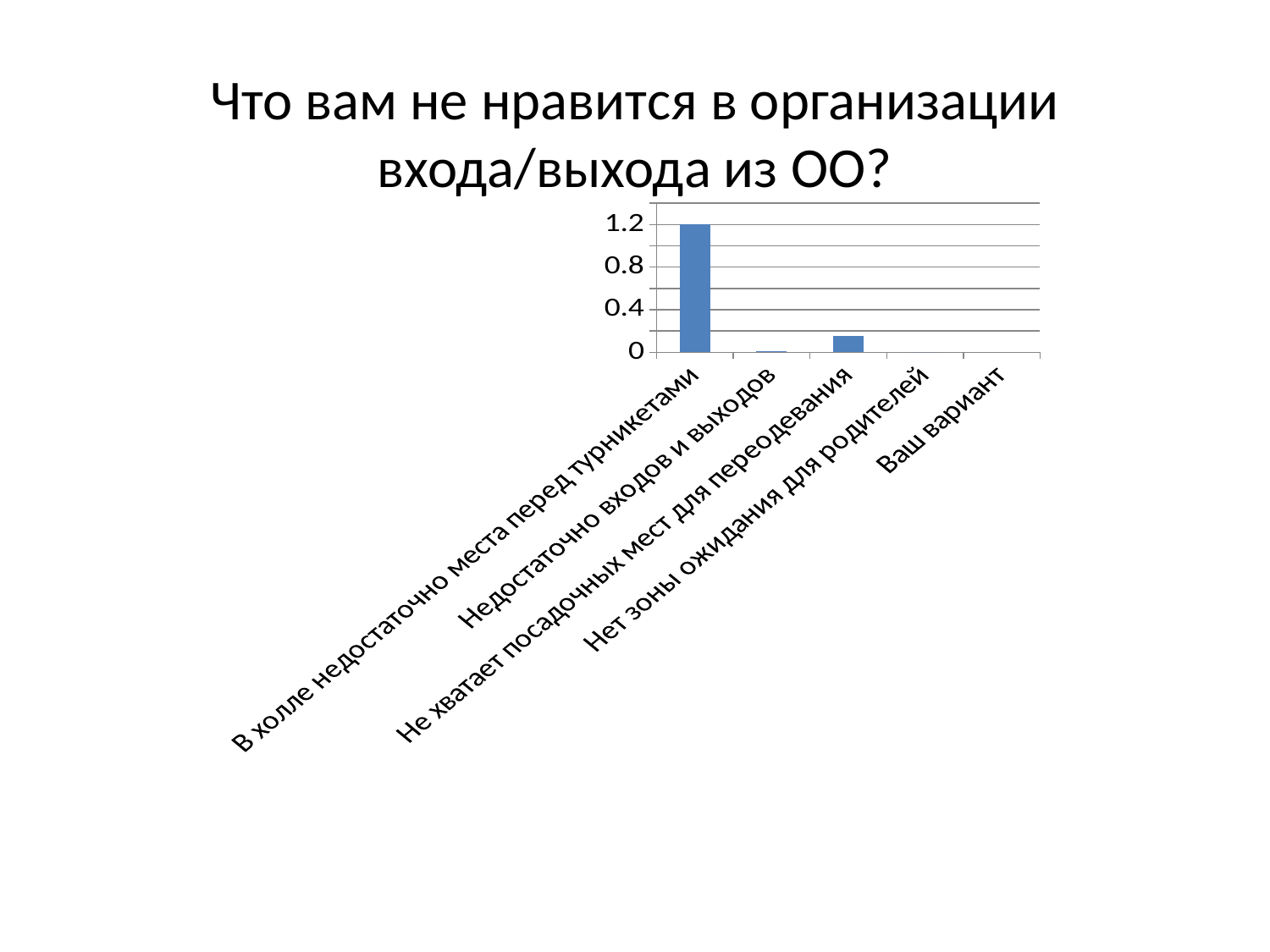
Is the value for "Недостаточно входов и выходов" greater or less than 0.4? less What is the value for "В холле недостаточно места перед турникетами"? 1.2 Which is larger: the value for "В холле недостаточно места перед турникетами" or the value for "Не хватает посадочных мест для переодевания"? В холле недостаточно места перед турникетами Is the value for "В холле недостаточно места перед турникетами" greater or less than 0.8? greater What kind of chart is shown on the slide? bar chart What is the title of the slide containing the chart? Что вам не нравится в организации входа/выхода из ОО? How many categories are shown on the x axis of the chart? 5 What is the highest value shown on the y axis of the chart? 1.2 Which category has the highest value in the chart? В холле недостаточно места перед турникетами Is the value for "Не хватает посадочных мест для переодевания" greater or less than 0.4? less Which is larger: the value for "Не хватает посадочных мест для переодевания" or the value for "Недостаточно входов и выходов"? Не хватает посадочных мест для переодевания